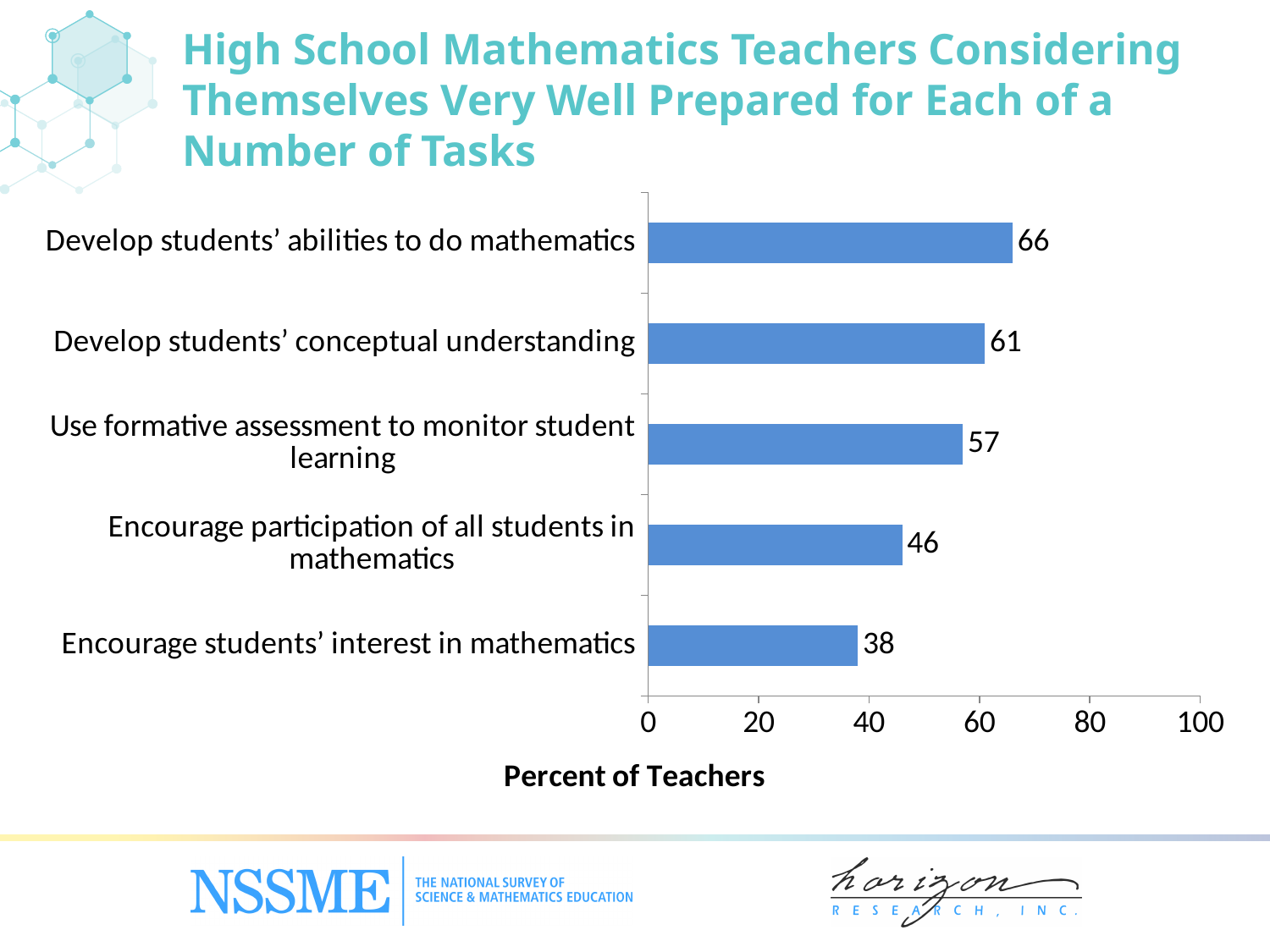
What percent of teachers consider themselves very well prepared to develop students' abilities to do mathematics? 66 What is the value for 'Encourage students' interest in mathematics'? 38 What kind of chart is shown on the slide? Bar chart What is the maximum value shown on the horizontal axis? 100 Is the value for 'Encourage participation of all students in mathematics' greater or less than 40? greater Which task has the highest percent of teachers? Develop students' abilities to do mathematics What is the value for 'Use formative assessment to monitor student learning'? 57 What is the label of the horizontal axis? Percent of Teachers Which task has the lowest percent of teachers? Encourage students' interest in mathematics How many tasks are shown in the chart? 5 What is the difference between the values for 'Develop students' conceptual understanding' and 'Encourage participation of all students in mathematics'? 15 Which is larger: the value for 'Develop students' conceptual understanding' or 'Use formative assessment to monitor student learning'? Develop students' conceptual understanding